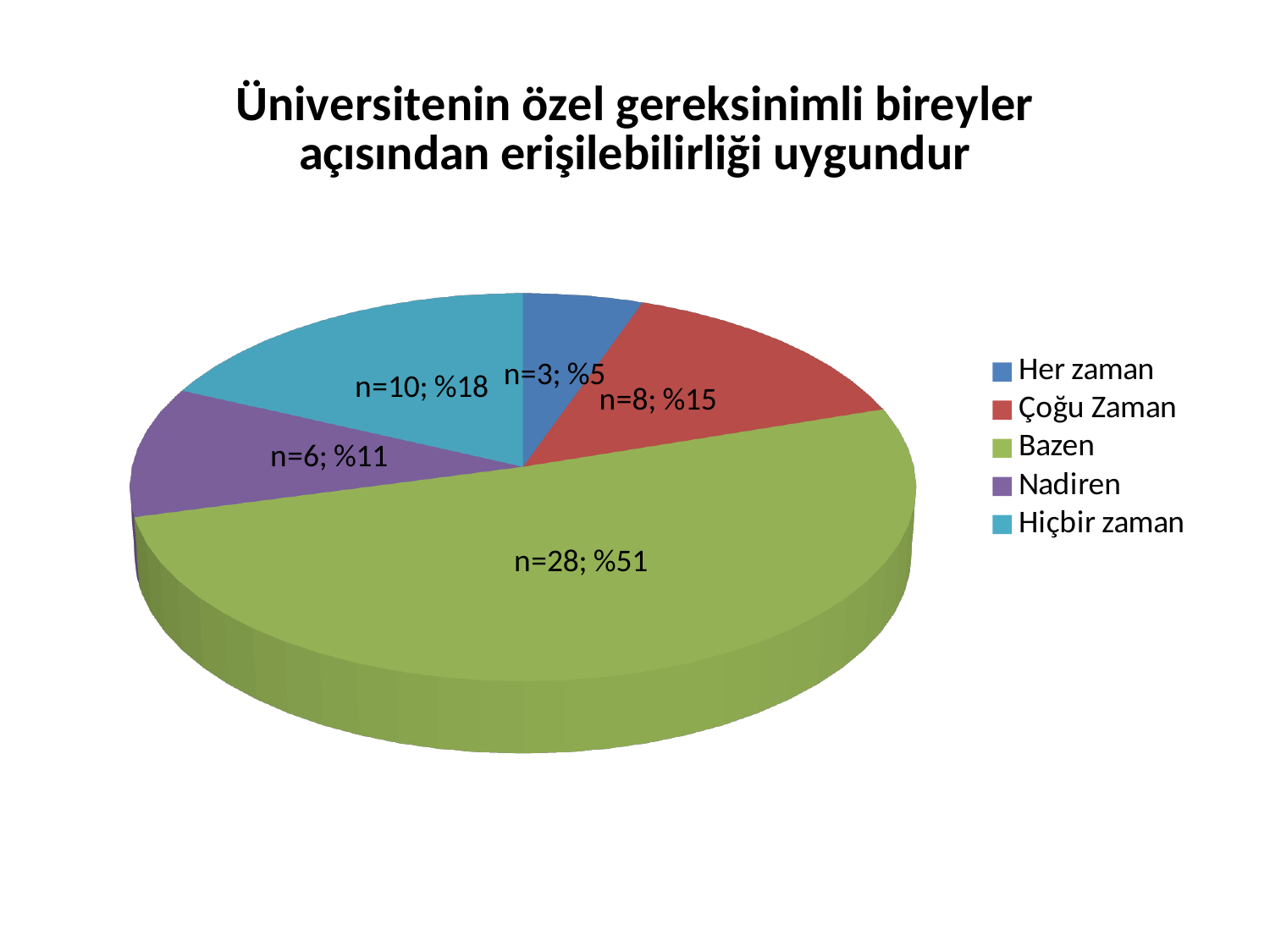
How many categories does the legend list? 5 What colour is the Bazen slice? green What is the data label for the Bazen slice? n=28; %51 Which has a larger n, Çoğu Zaman or Nadiren? Çoğu Zaman What is the data label for the Hiçbir zaman slice? n=10; %18 What is the data label for the Nadiren slice? n=6; %11 Which category has the smallest slice? Her zaman What kind of chart is shown on the slide? pie chart What is the difference in n between Bazen and Hiçbir zaman? 18 What percentage share does the Çoğu Zaman slice have? %15 Which category has the largest slice? Bazen What is the data label for the Her zaman slice? n=3; %5